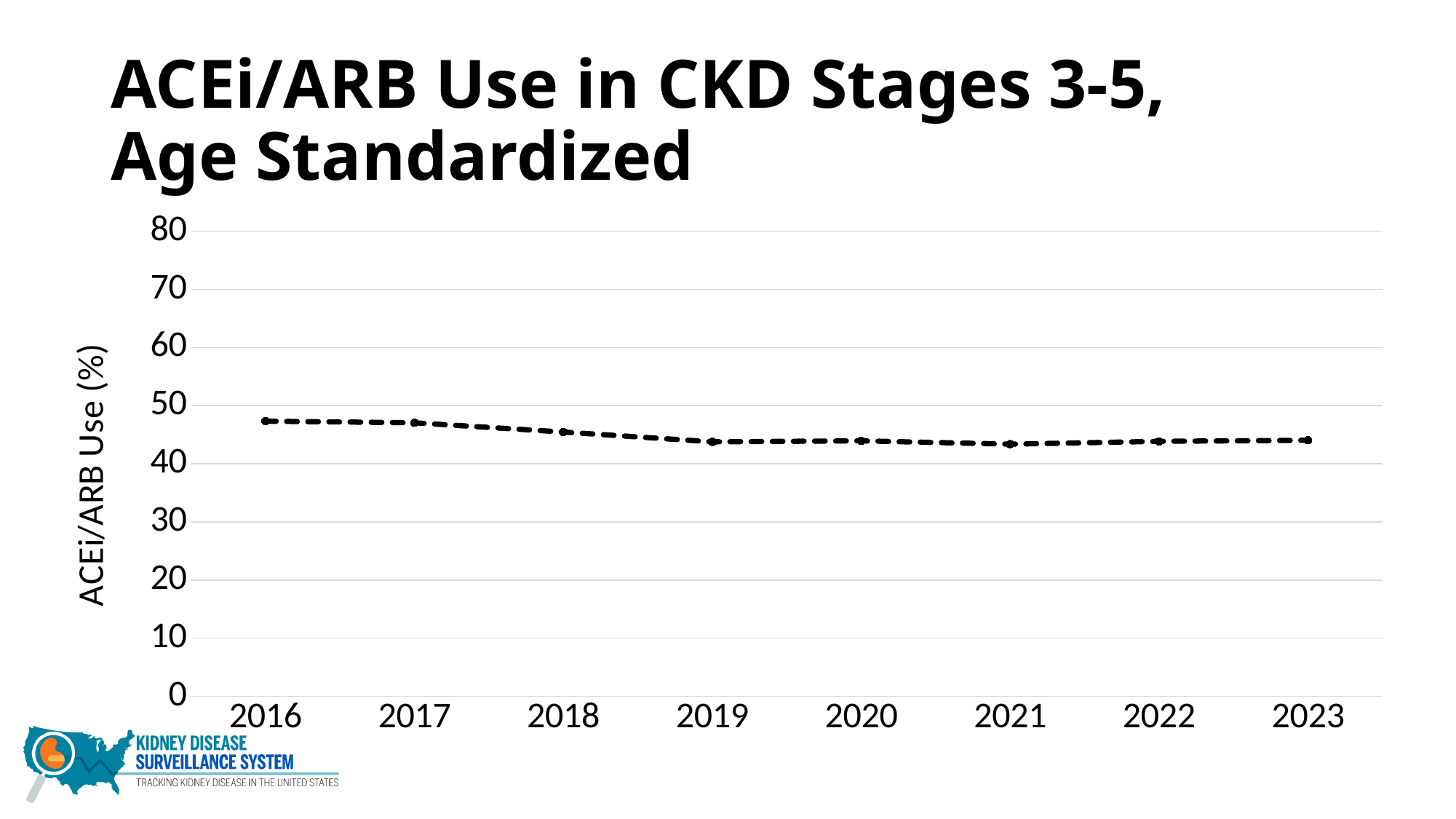
Is the value for 2016 greater or less than 40? greater Is the value for 2016 greater or less than 50? less Is the value for 2019 greater or less than 60? less Which year has the larger value, 2017 or 2021? 2017 How many years are plotted along the x axis? 8 What is the label of the y axis? ACEi/ARB Use (%) What is the title of the chart? ACEi/ARB Use in CKD Stages 3-5, Age Standardized Do the values generally rise or fall from 2016 to 2019? fall Which year has the larger value, 2016 or 2023? 2016 What kind of chart is shown on the slide? line chart